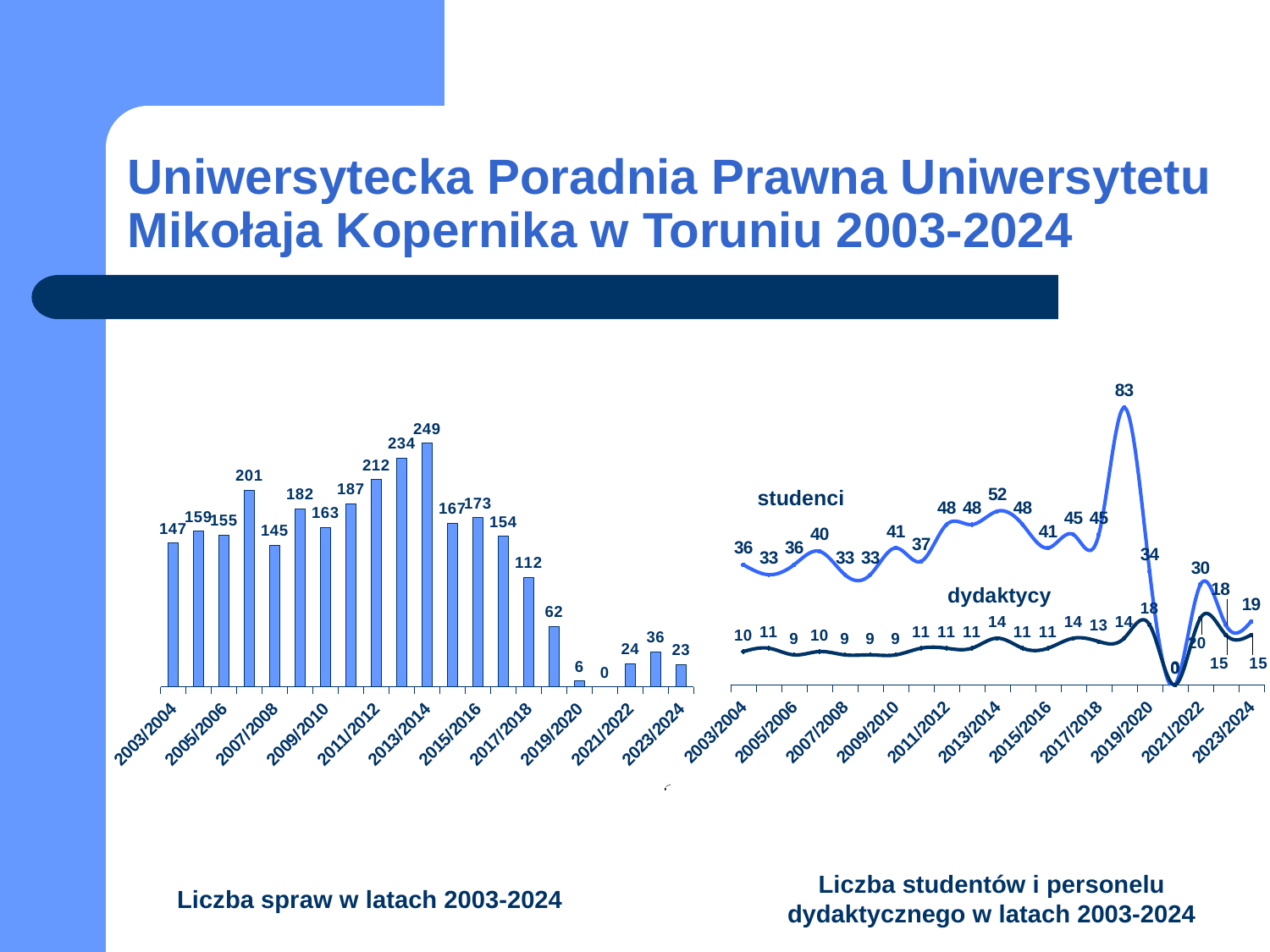
How many bars are plotted in the chart 'Liczba spraw w latach 2003-2024'? 21 In the chart 'Liczba spraw w latach 2003-2024', what is the difference between the values for 2013/2014 and 2003/2004? 102 In the chart 'Liczba spraw w latach 2003-2024', which is larger: the value for 2007/2008 or for 2009/2010? 2009/2010 In the chart 'Liczba spraw w latach 2003-2024', which year has the highest number of cases? 2013/2014 In the chart 'Liczba studentów i personelu dydaktycznego w latach 2003-2024', what is the value for dydaktycy in 2003/2004? 10 In the chart 'Liczba studentów i personelu dydaktycznego w latach 2003-2024', what is the highest value for studenci? 83 How many series are plotted in the chart 'Liczba studentów i personelu dydaktycznego w latach 2003-2024'? 2 In the chart 'Liczba studentów i personelu dydaktycznego w latach 2003-2024', what is the value for studenci in 2013/2014? 52 In the chart 'Liczba spraw w latach 2003-2024', what is the value for 2003/2004? 147 In the chart 'Liczba studentów i personelu dydaktycznego w latach 2003-2024', what is the difference between studenci and dydaktycy in 2023/2024? 4 What kind of chart is 'Liczba spraw w latach 2003-2024'? Bar chart In the chart 'Liczba spraw w latach 2003-2024', what is the value for 2013/2014? 249